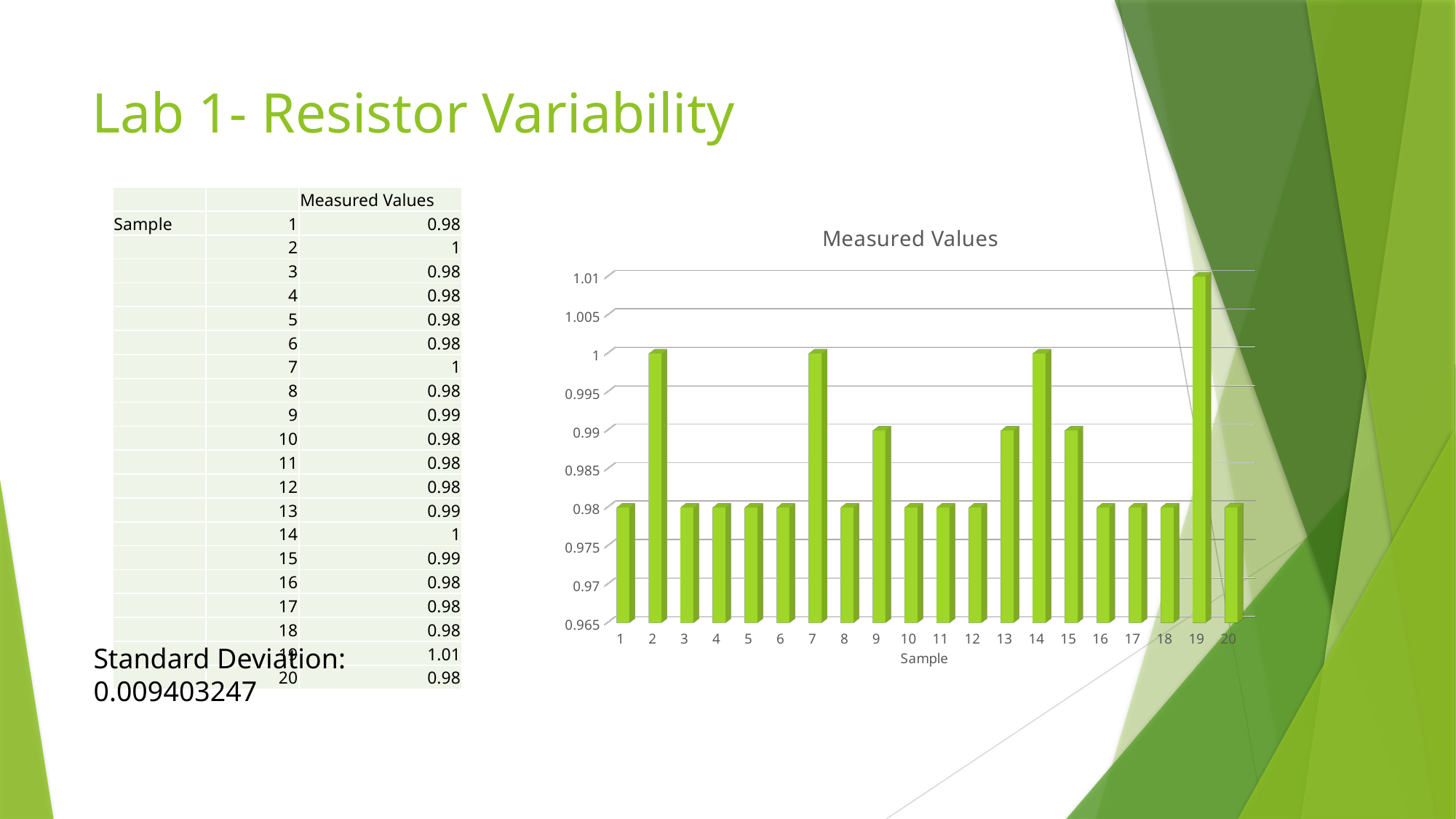
How many samples are plotted in the chart? 20 Which has a larger measured value, sample 14 or sample 15? sample 14 What is the label on the x axis of the chart? Sample What is the measured value for sample 19? 1.01 Which sample has the highest measured value? 19 What is the difference between the measured values of sample 19 and sample 1? 0.03 What is the measured value for sample 9? 0.99 Is the measured value for sample 7 greater or less than 0.99? greater What type of chart is shown on the slide? bar chart What is the difference between the measured values of sample 13 and sample 12? 0.01 What is the measured value for sample 2? 1 What is the title of the chart? Measured Values